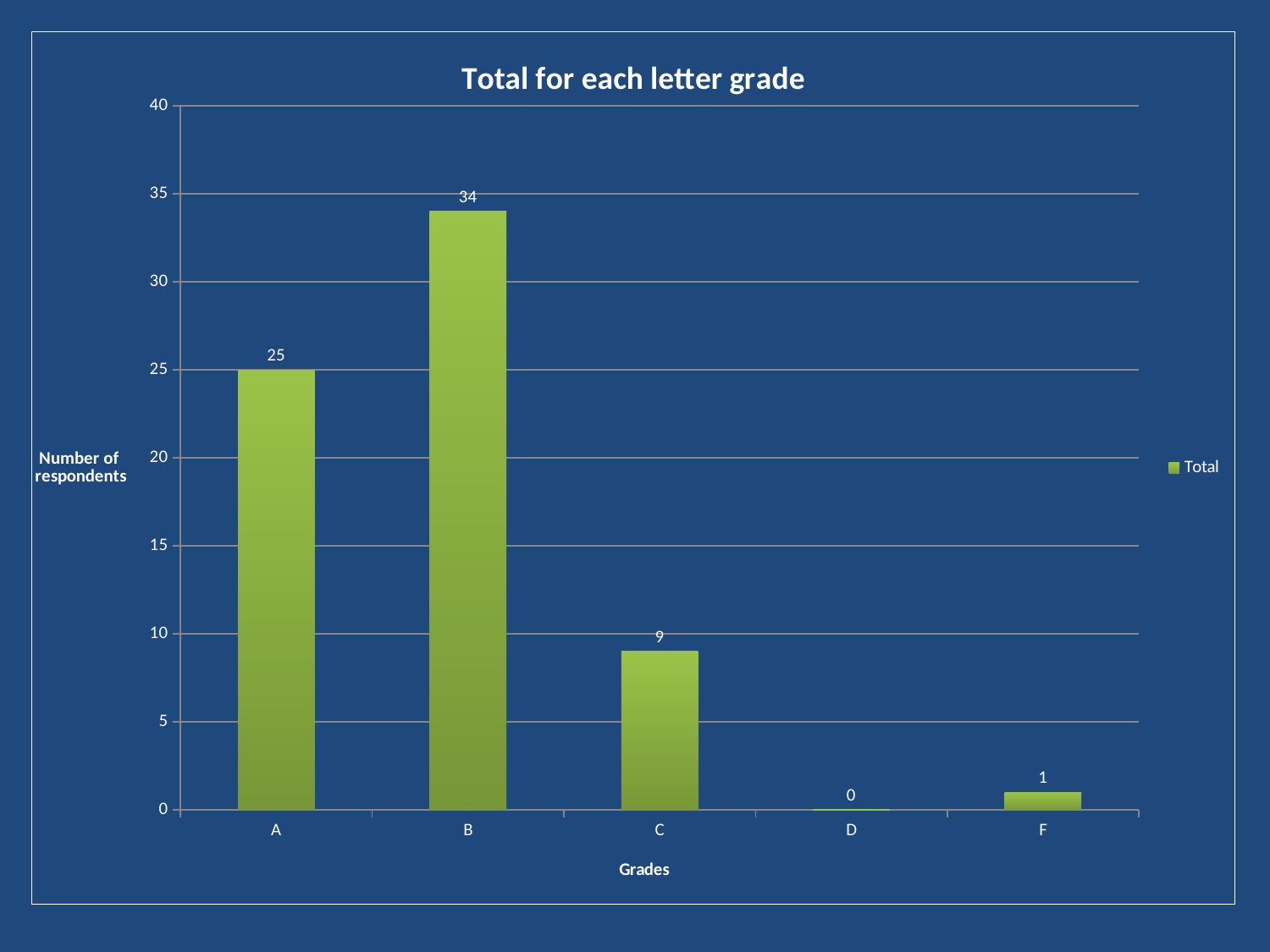
What is the title of the chart? Total for each letter grade What is the value for grade B? 34 Which grade has the highest number of respondents? B Which grade has the lowest number of respondents? D What kind of chart is shown on the slide? bar chart Which is larger, the value for grade C or the value for grade F? C What is the value for grade D? 0 What is the value for grade C? 9 What is the difference between the values for grade B and grade A? 9 Is the value for grade B greater or less than 30? greater What is the value for grade A? 25 How many grade categories are shown on the x axis? 5